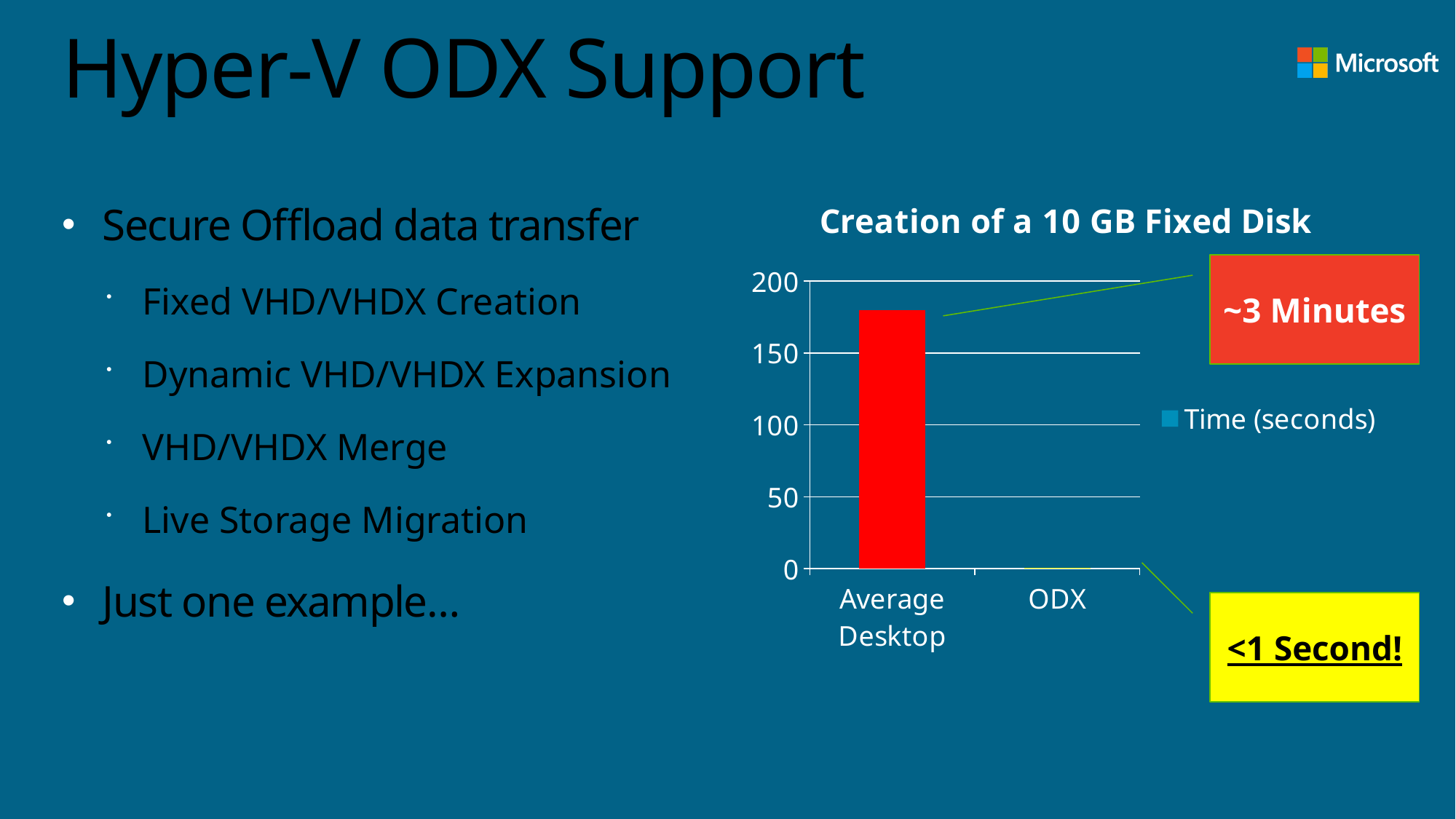
Is the value for Average Desktop greater or less than 150? greater How many series does the chart legend list? 1 Which category has the highest value in the chart? Average Desktop What series name does the chart legend show? Time (seconds) What kind of chart is shown on the slide? Bar chart Which has a larger value, Average Desktop or ODX? Average Desktop What is the highest tick value shown on the y axis of the chart? 200 Is the value for Average Desktop greater or less than 200? less What is the title of the chart? Creation of a 10 GB Fixed Disk How many categories are shown on the x axis of the chart? 2 Is the value for ODX greater or less than 50? less Which category has the lowest value in the chart? ODX